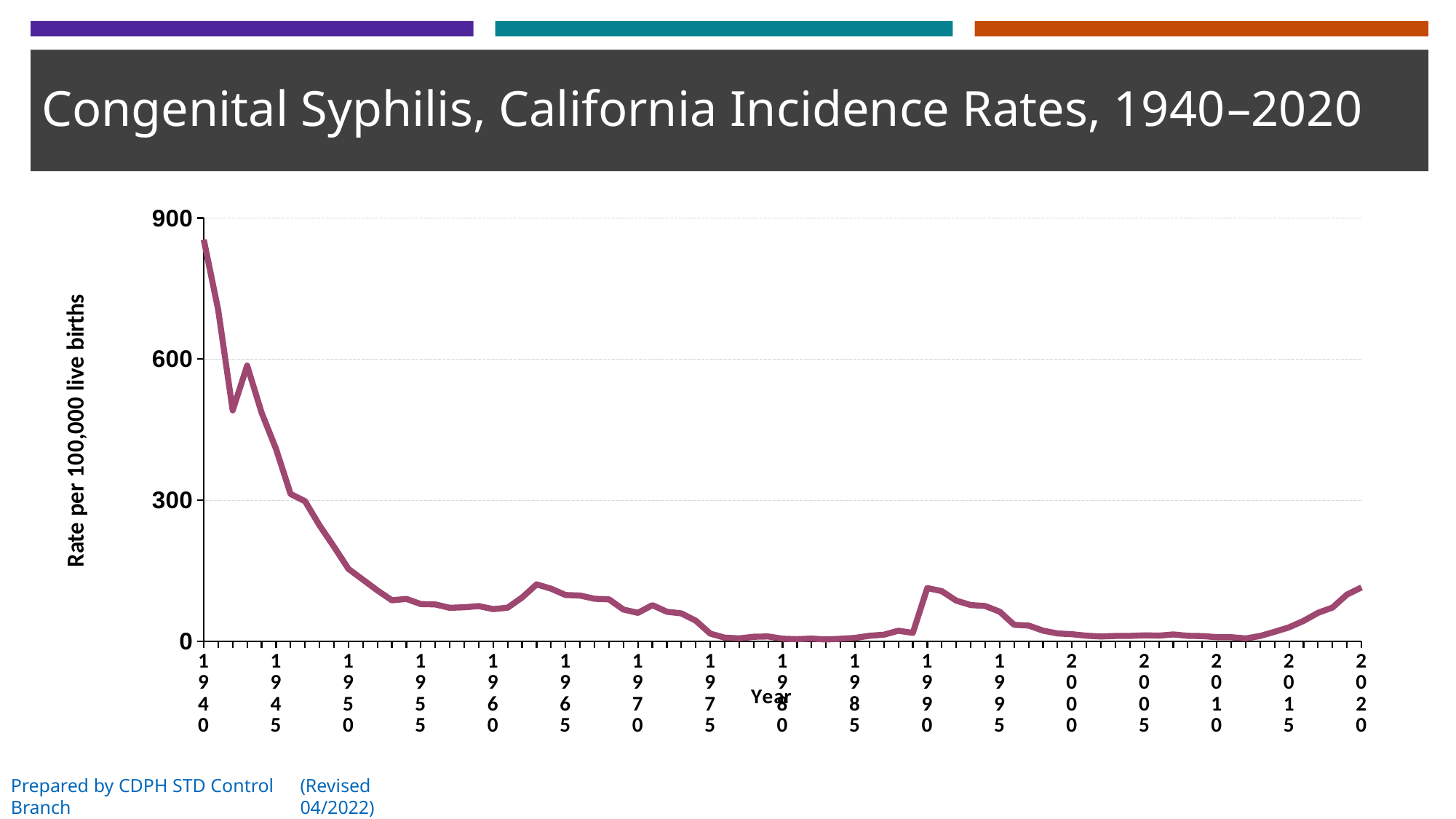
In which year is the congenital syphilis rate highest? 1940 What is the title of the slide's chart? Congenital Syphilis, California Incidence Rates, 1940–2020 Does the rate rise or fall between 1940 and 1950? fall Which year has the higher rate, 1990 or 1980? 1990 Is the rate for 1950 greater or less than 300? less Is the rate for 1940 greater or less than 600? greater What kind of chart is shown on the slide? line chart Is the rate for 2020 greater or less than 300? less Does the rate rise or fall between 2012 and 2020? rise What is the label of the vertical axis? Rate per 100,000 live births Which year has the higher rate, 1940 or 2020? 1940